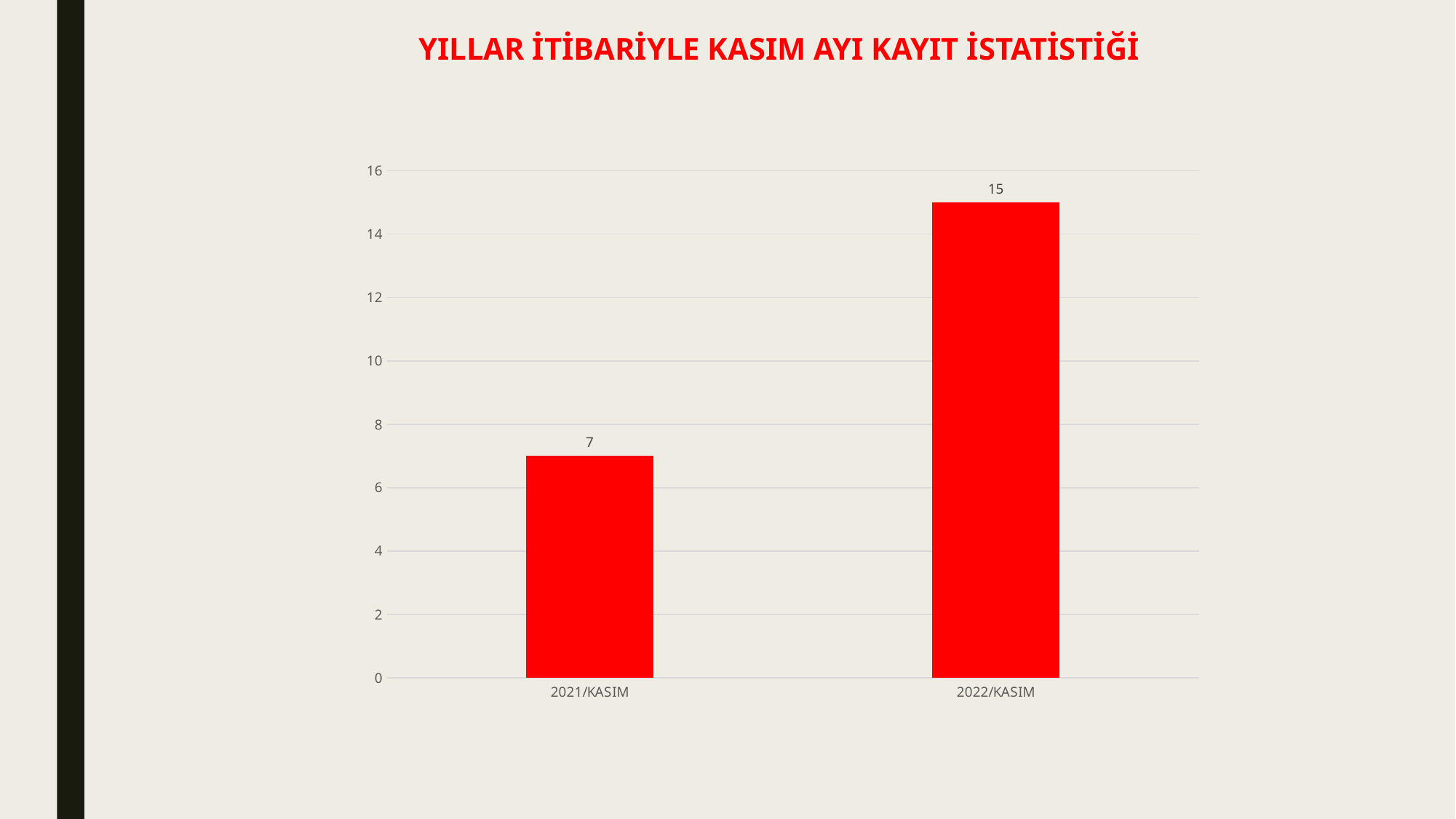
What is the difference between the values for 2022/KASIM and 2021/KASIM? 8 Is the value for 2021/KASIM greater or less than 8? less What is the value for 2021/KASIM? 7 What is the value for 2022/KASIM? 15 What kind of chart is shown on the slide? bar chart Which category has the highest value? 2022/KASIM How many categories are shown on the x axis? 2 Which is larger, the value for 2021/KASIM or the value for 2022/KASIM? 2022/KASIM Do the values rise or fall from 2021/KASIM to 2022/KASIM? rise What is the title of the chart? YILLAR İTİBARİYLE KASIM AYI KAYIT İSTATİSTİĞİ Which category has the lowest value? 2021/KASIM Is the value for 2022/KASIM greater or less than 10? greater